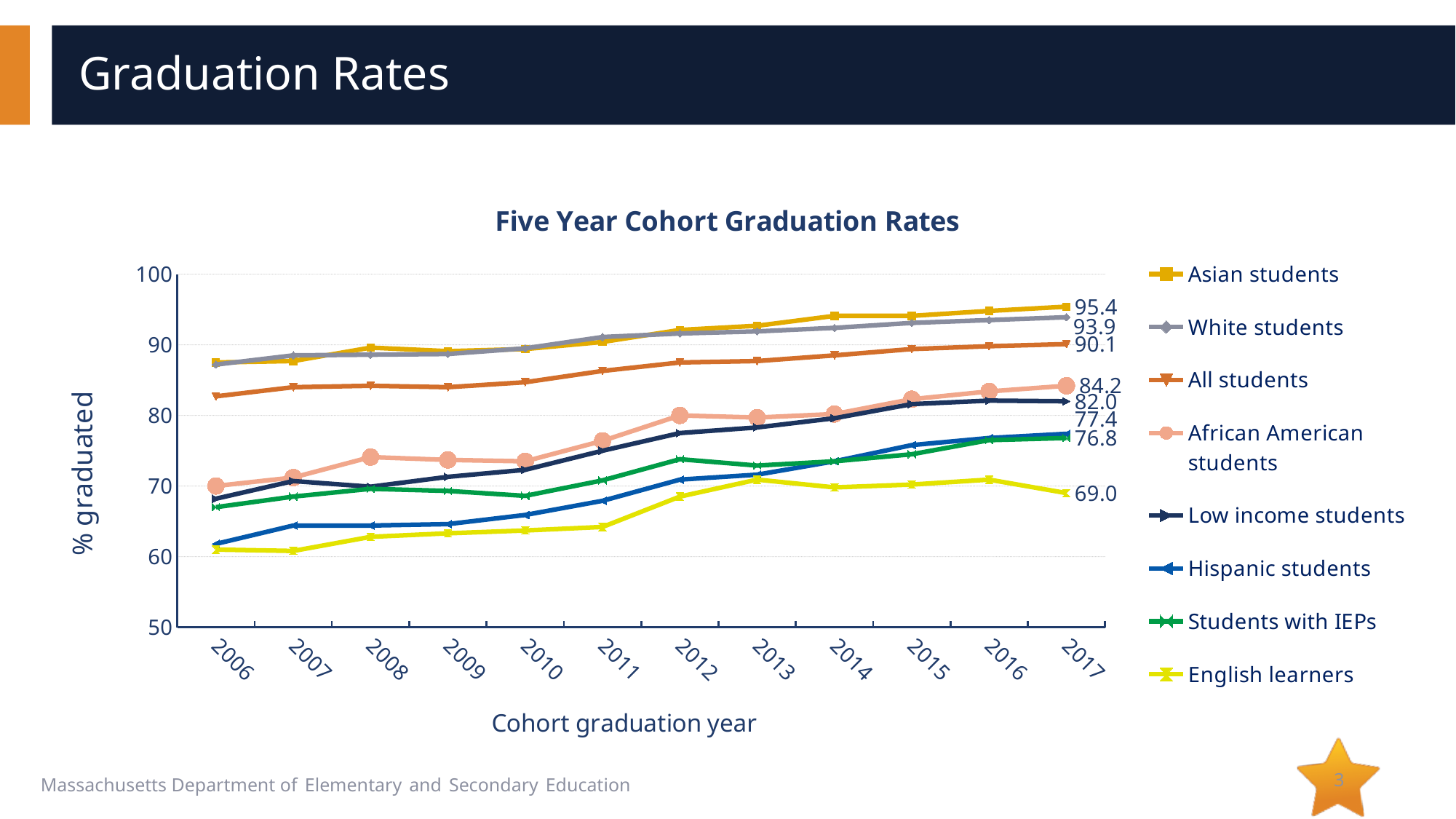
Which group has the lowest graduation rate in 2017? English learners What is the 2017 five year cohort graduation rate for Asian students? 95.4 What is the title of the chart? Five Year Cohort Graduation Rates How many cohort graduation years are shown on the x axis? 12 What type of chart is shown on the slide? line chart How many series does the legend list? 8 Is the 2006 graduation rate for Hispanic students greater or less than 70? less What is the 2017 five year cohort graduation rate for English learners? 69.0 Which group has the highest graduation rate in 2017? Asian students What is the 2017 five year cohort graduation rate for All students? 90.1 In 2017, which is larger: the graduation rate for Low income students or for Hispanic students? Low income students What is the difference between the 2017 graduation rates of White students and African American students? 9.7